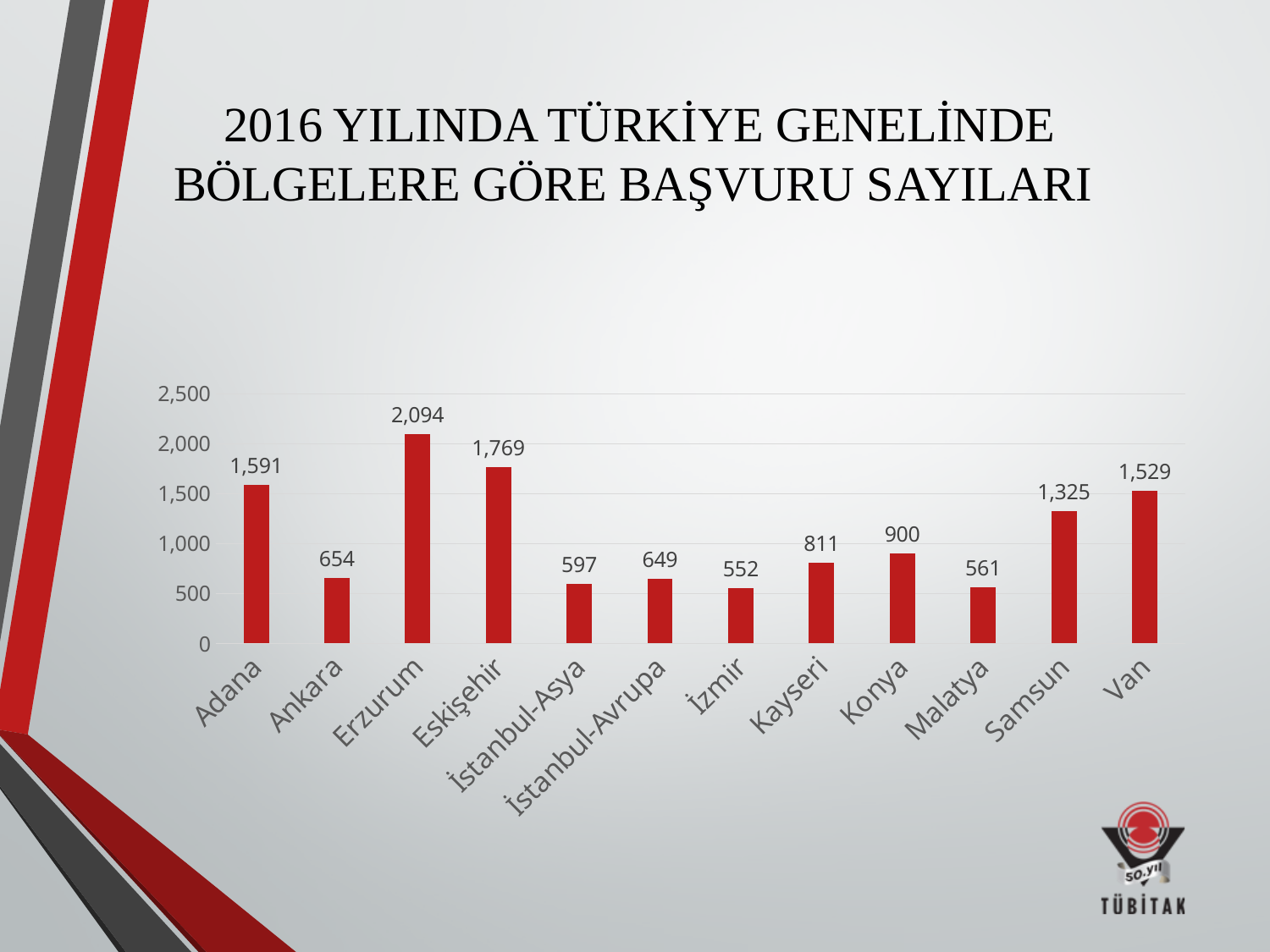
What is the value for Erzurum? 2,094 Which is larger, the value for Kayseri or the value for Konya? Konya How many categories are shown on the x axis? 12 Which category has the highest value? Erzurum What is the title of the slide? 2016 YILINDA TÜRKİYE GENELİNDE BÖLGELERE GÖRE BAŞVURU SAYILARI What kind of chart is shown on the slide? bar chart Which category has the lowest value? İzmir Is the value for Malatya greater or less than 1,000? less What is the value for İstanbul-Avrupa? 649 What is the difference between the values for Adana and Van? 62 What is the difference between the values for Erzurum and Eskişehir? 325 What is the value for Samsun? 1,325